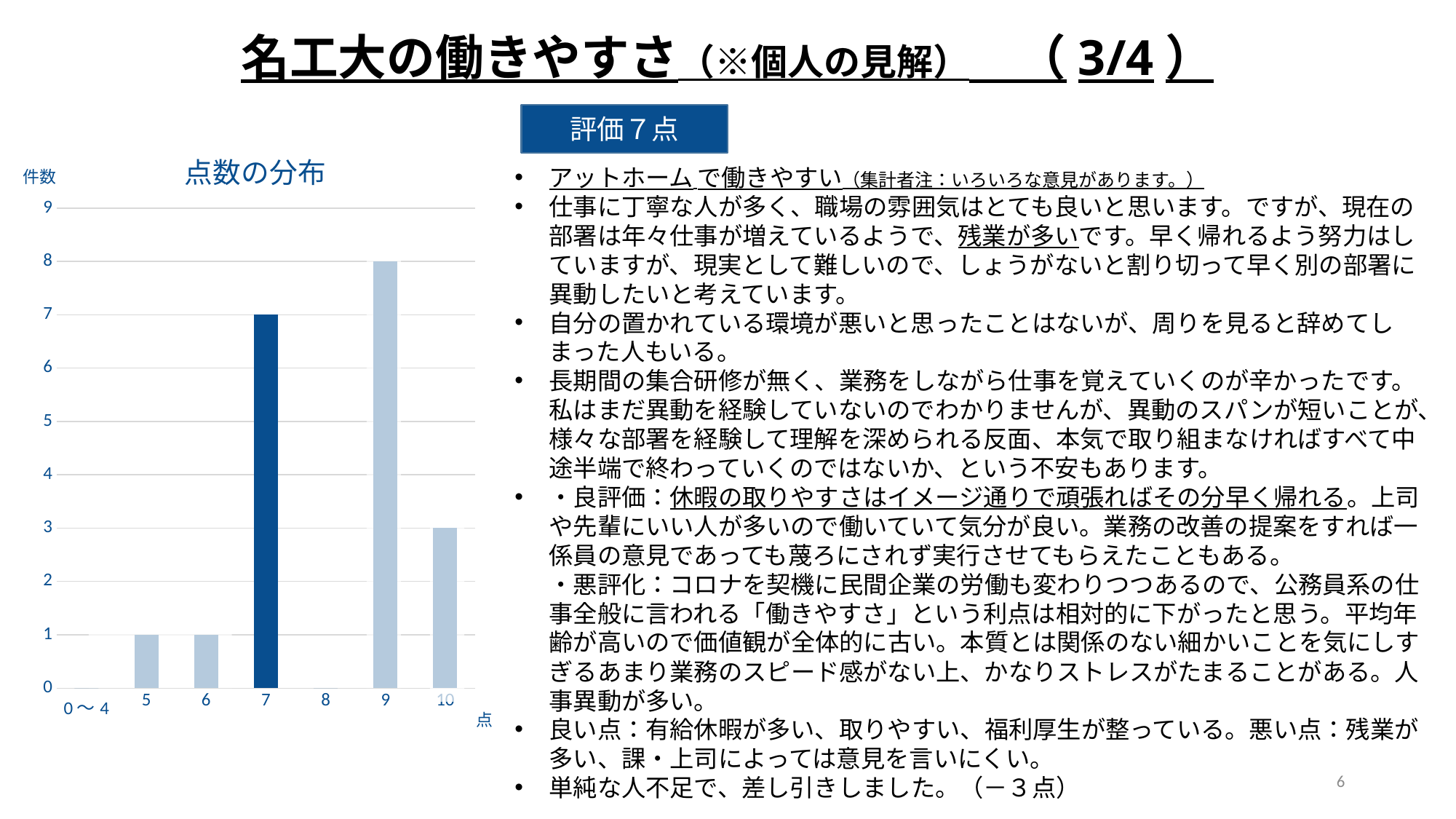
What is the count (件数) for score 7? 7 Which has a larger count, score 7 or score 10? 7 What is the title of the chart? 点数の分布 What is the difference between the counts for score 9 and score 7? 1 How many categories are shown on the x axis of the chart? 7 What kind of chart is shown on the slide? bar chart Which score category has the highest count in the chart? 9 What is the count (件数) for score 10? 3 What is the count (件数) for score 5? 1 Is the count for score 9 greater or less than 5? greater Which score category's bar is drawn in a darker blue than the others? 7 What is the count (件数) for score 9? 8